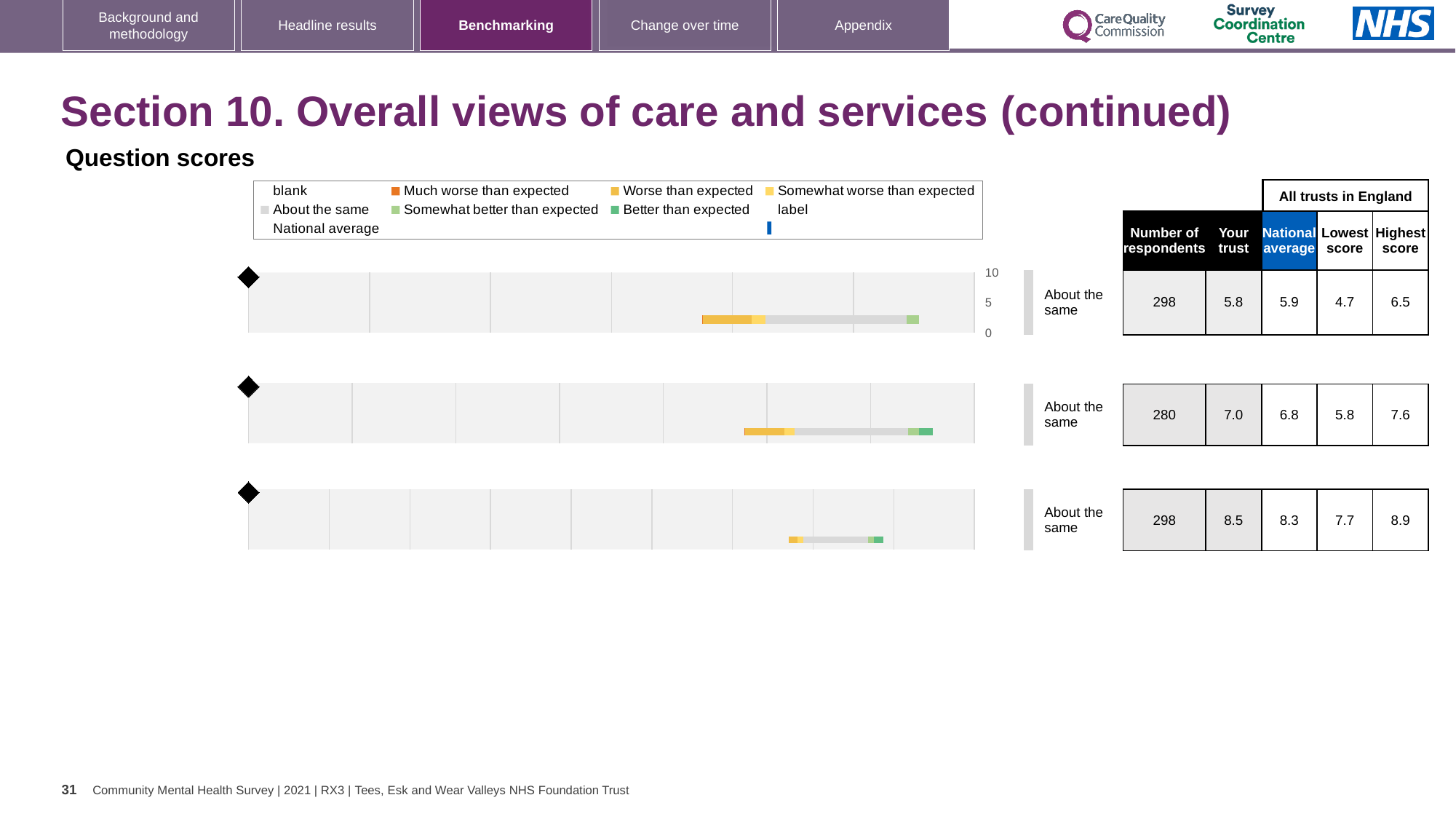
In the top chart, what is the National average score? 5.9 In the bottom chart, what is the Lowest score among all trusts in England? 7.7 In the middle chart, what is the Highest score among all trusts in England? 7.6 In the bottom chart, what is the difference between the Highest score and the Lowest score? 1.2 In the top chart, what is the score for Your trust? 5.8 What benchmark category is shown next to the middle chart? About the same In the top chart, is the Your trust score greater or less than 5? greater What kind of chart is used for each question score? Bar chart How many question charts are shown on the slide? 3 In the middle chart, how many respondents are there? 280 In the middle chart, how much higher is the Your trust score than the National average? 0.2 In the bottom chart, which is larger, the Your trust score or the National average? Your trust